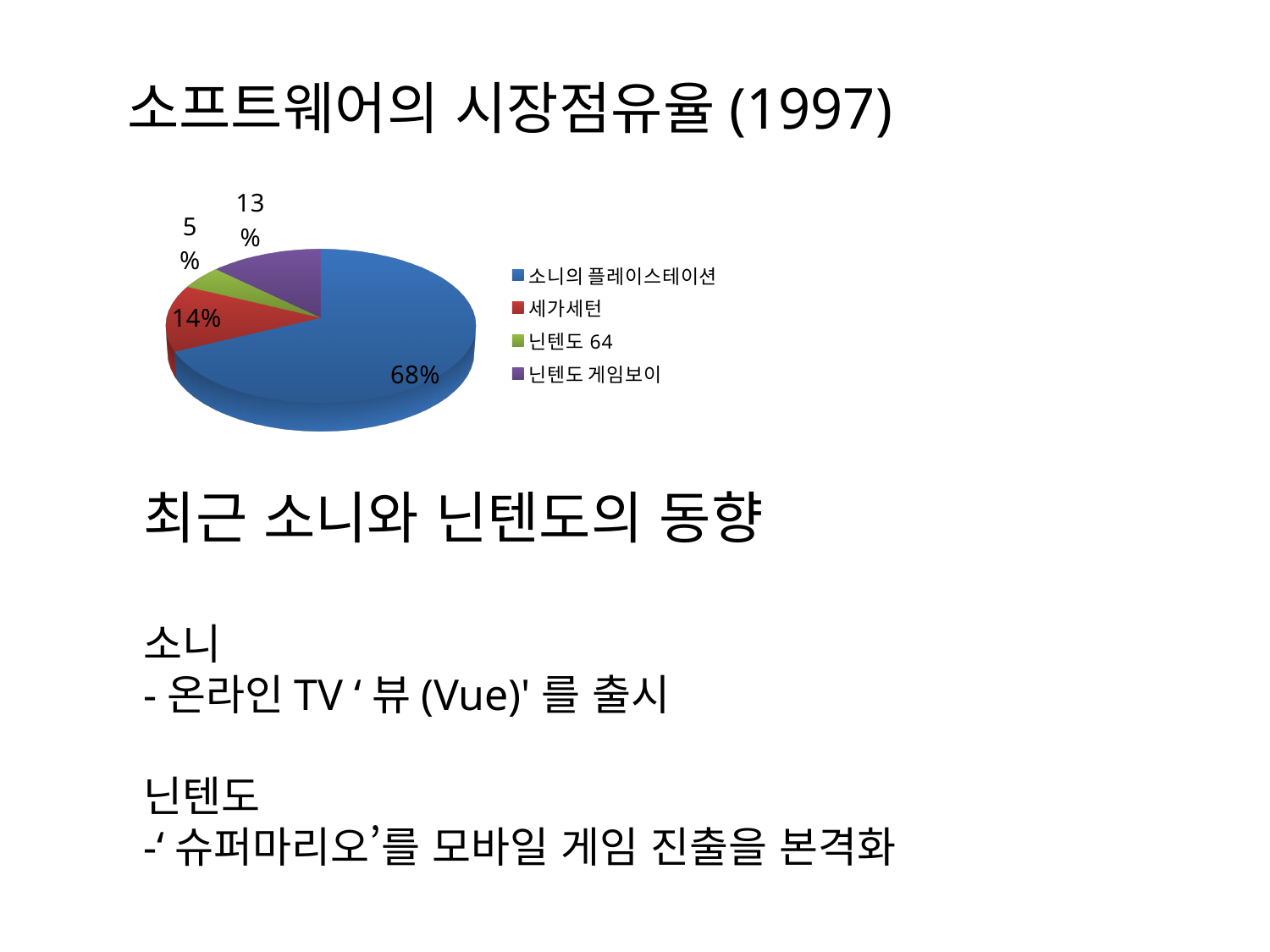
Which has a larger share, 세가세턴 or 닌텐도 게임보이? 세가세턴 Which category has the smallest share of the pie? 닌텐도 64 What is the difference between the shares of 소니의 플레이스테이션 and 세가세턴? 54% What is the difference between the shares of 닌텐도 게임보이 and 닌텐도 64? 8% Which category has the largest share of the pie? 소니의 플레이스테이션 What is the value shown for 닌텐도 게임보이? 13% What is the title of the chart? 소프트웨어의 시장점유율 (1997) What is the value shown for 닌텐도 64? 5% What is the value shown for 세가세턴? 14% What share of the pie does 소니의 플레이스테이션 hold? 68% How many slices does the pie chart have? 4 What type of chart is shown on the slide? Pie chart